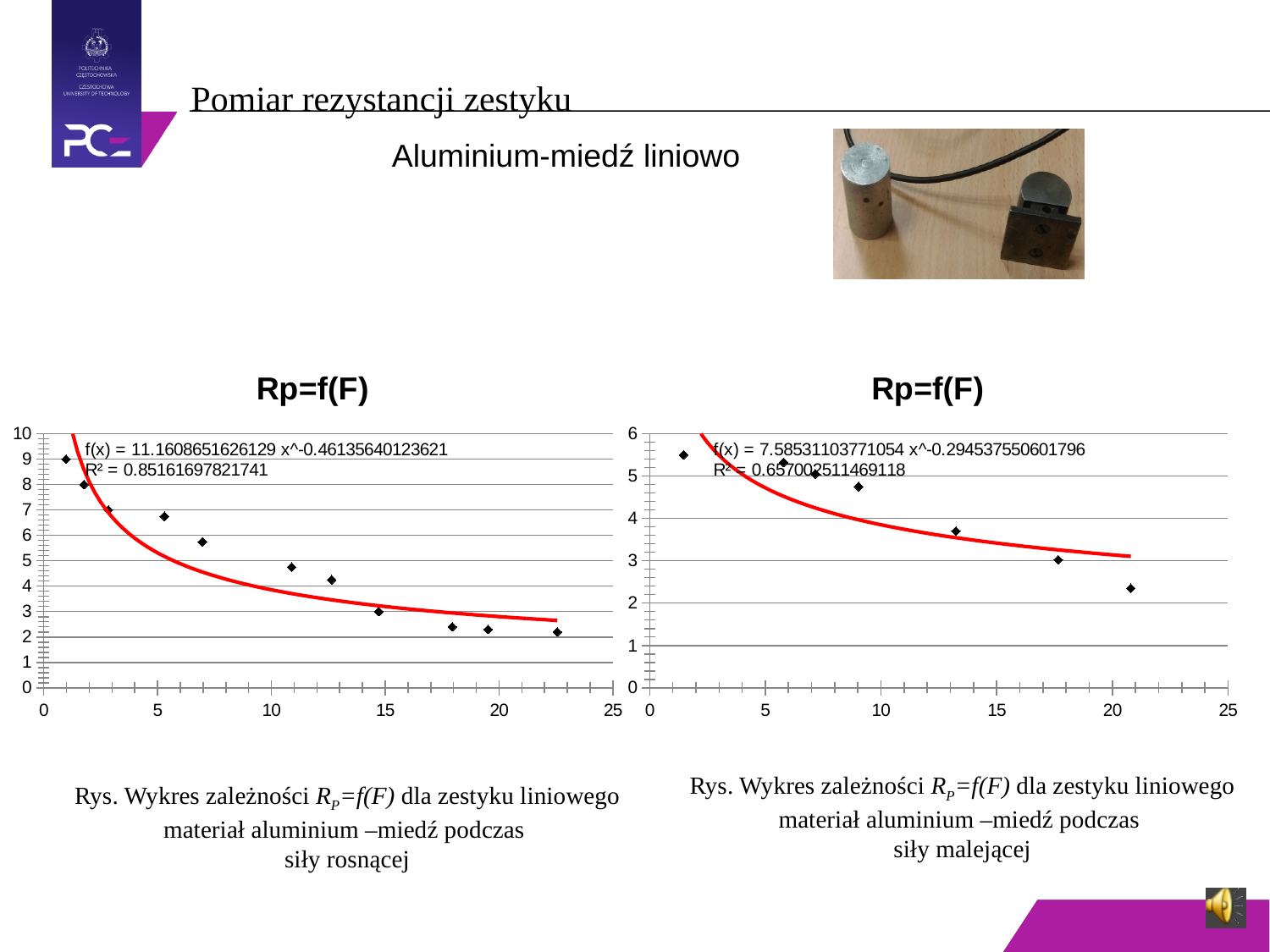
In the left chart (siły rosnącej), is the value of the first data point (at F of about 1) greater or less than 8? greater What is the maximum value shown on the y axis of the right chart (siły malejącej)? 6 In the right chart (siły malejącej), is the value of the first data point (at F of about 1.5) greater or less than 5? greater How many data points are plotted in the right chart (siły malejącej)? 7 In the left chart (siły rosnącej), which data point has the highest value: the one at the smallest F or the one at the largest F? the one at the smallest F In the right chart (siły malejącej), is the value of the last data point (at F of about 21) greater or less than 3? less What kind of chart is the left chart titled Rp=f(F)? scatter chart How many data points are plotted in the left chart (siły rosnącej)? 11 In the right chart (siły malejącej), do the plotted values rise or fall as F increases along the x axis? fall In the left chart (siły rosnącej), do the plotted values rise or fall as F increases along the x axis? fall What is the R² value shown on the left chart (siły rosnącej)? 0.85161697821741